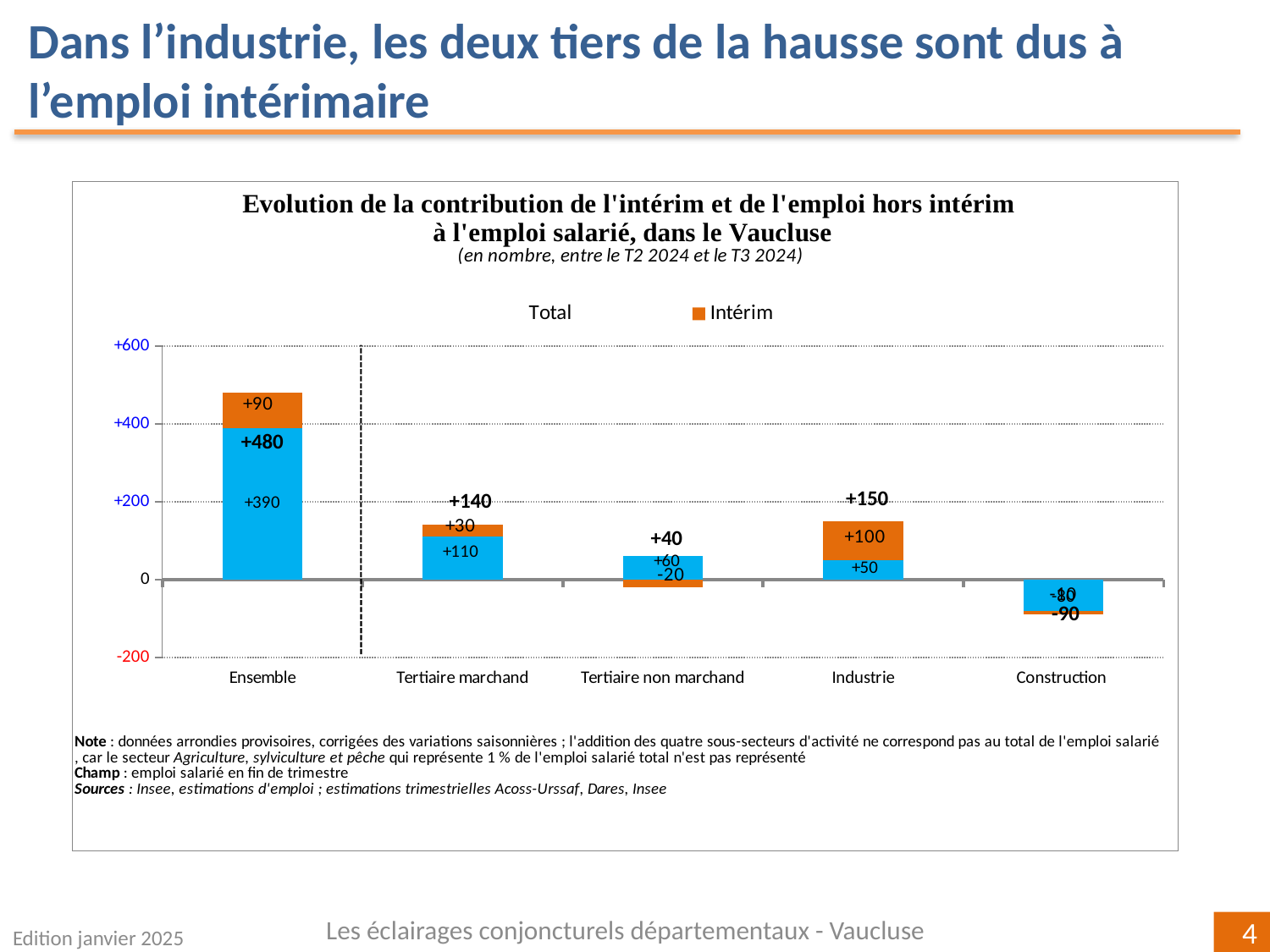
How many categories are shown on the x axis? 5 Is the Intérim value larger for Ensemble or for Industrie? Industrie What kind of chart is this? Bar chart What is the Intérim value shown for Industrie? +100 What is the total value labelled for Industrie? +150 What is the total value labelled for Ensemble? +480 Among the four sub-sectors (excluding Ensemble), which has the highest total value? Industrie What is the Intérim value shown for Tertiaire non marchand? -20 Which category has the lowest total value? Construction What is the total value labelled for Tertiaire marchand? +140 What is the value of the blue bar for Ensemble? +390 What is the difference between the Intérim value for Industrie and the Intérim value for Tertiaire marchand? 70